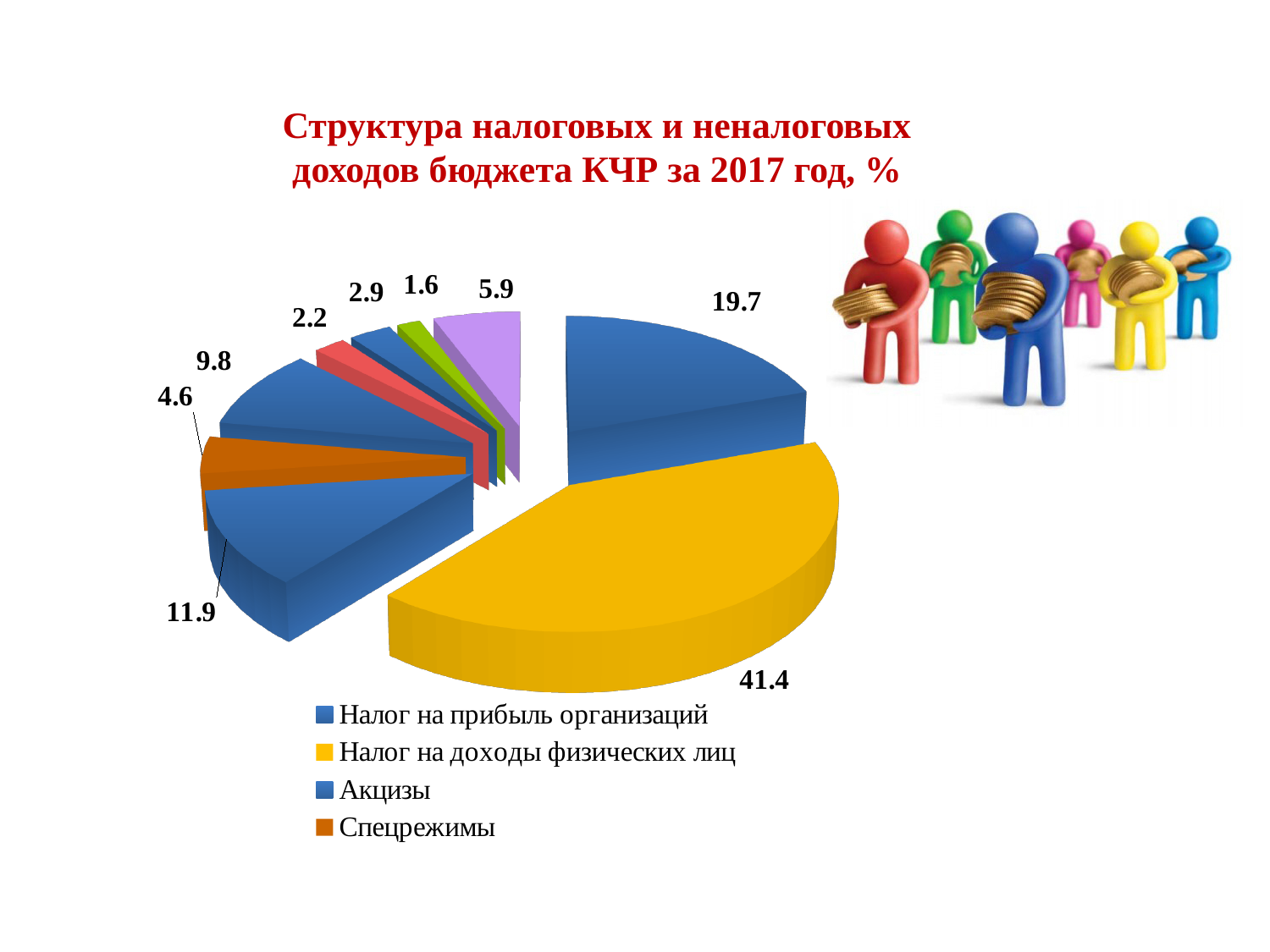
What is the smallest value labelled on the pie chart? 1.6 What is the value for Акцизы? 11.9 What is the value for Налог на прибыль организаций? 19.7 How many slices does the pie chart have? 9 How many entries does the legend list? 4 What type of chart is shown on the slide? Pie chart What is the difference between the values for Налог на доходы физических лиц and Налог на прибыль организаций? 21.7 What is the value for Спецрежимы? 4.6 Which category has the largest slice of the pie? Налог на доходы физических лиц What is the value for Налог на доходы физических лиц? 41.4 Which is larger, the value for Акцизы or the value for Спецрежимы? Акцизы What is the title of the chart? Структура налоговых и неналоговых доходов бюджета КЧР за 2017 год, %